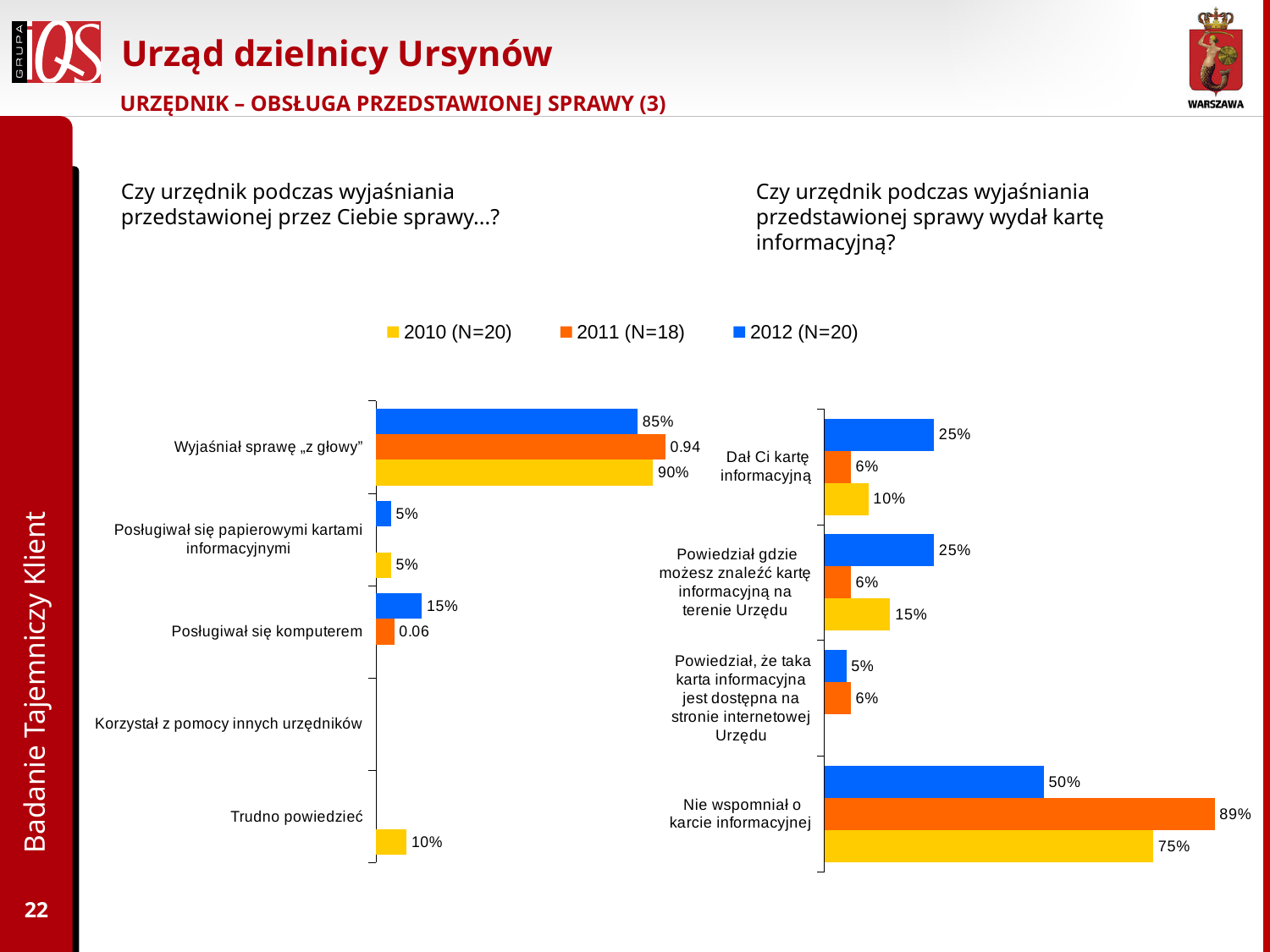
In the right chart, which category has the highest 2012 value? Nie wspomniał o karcie informacyjnej In the right chart, what is the difference between the 2011 and 2010 values for "Nie wspomniał o karcie informacyjnej"? 14% How many series does the legend list? 3 In the right chart, what is the 2011 value for "Nie wspomniał o karcie informacyjnej"? 89% In the left chart, what is the 2010 value for "Wyjaśniał sprawę „z głowy”"? 90% In the left chart, what is the 2012 value for "Posługiwał się komputerem"? 15% In the right chart, what is the 2012 value for "Dał Ci kartę informacyjną"? 25% What kind of chart is the left chart? Bar chart In the left chart, what is the 2010 value for "Trudno powiedzieć"? 10% How many categories are shown in the right chart? 4 In the right chart, which is larger for "Powiedział gdzie możesz znaleźć kartę informacyjną na terenie Urzędu": the 2012 value or the 2010 value? 2012 In the left chart, what is the 2012 value for "Wyjaśniał sprawę „z głowy”"? 85%